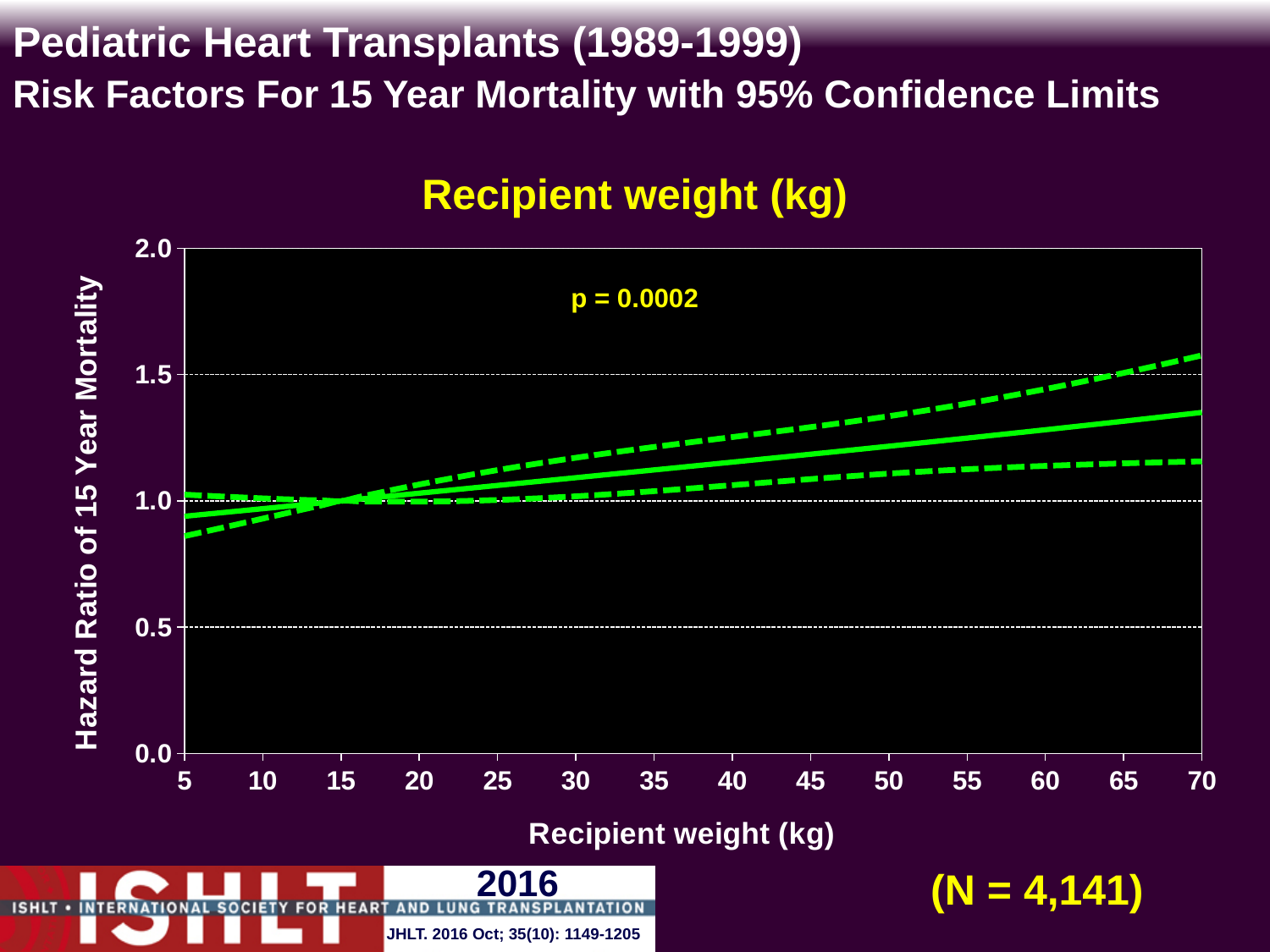
What is the label of the y axis? Hazard Ratio of 15 Year Mortality Is the hazard ratio (solid line) at a recipient weight of 70 kg greater or less than 1.0? greater How many lines are plotted on the chart? 3 What kind of chart is shown on the slide? line chart What p-value is shown on the chart? p = 0.0002 Does the solid hazard ratio line rise or fall as recipient weight increases from 5 kg to 70 kg? rise Is the lower confidence limit (lower dashed line) at a recipient weight of 5 kg greater or less than 1.0? less Is the upper confidence limit (upper dashed line) at a recipient weight of 70 kg greater or less than 1.5? greater Is the hazard ratio at a recipient weight of 70 kg larger or smaller than at 5 kg? larger